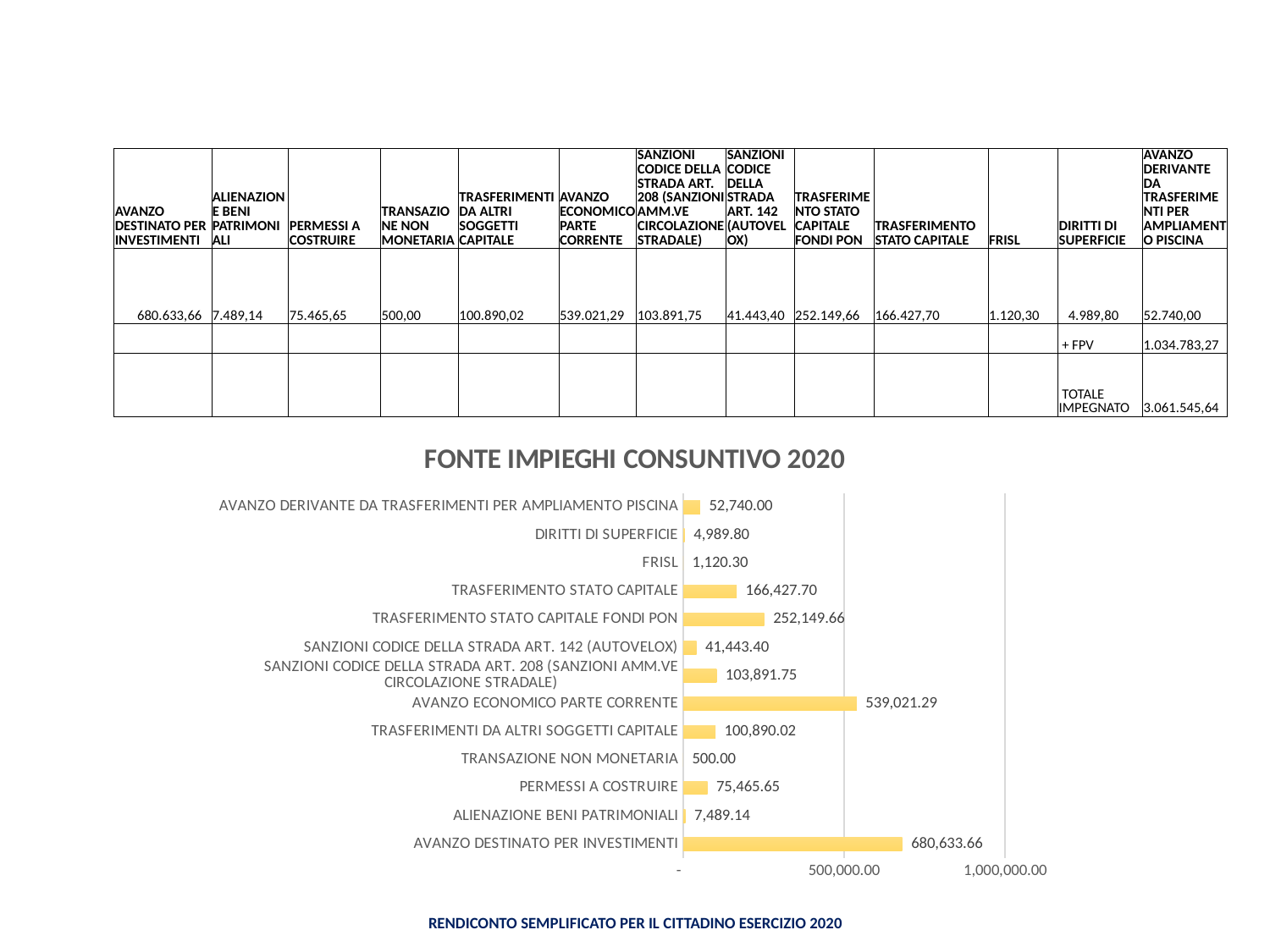
What is the value for FRISL? 1,120.30 What is the value for AVANZO DESTINATO PER INVESTIMENTI? 680,633.66 What is the value for SANZIONI CODICE DELLA STRADA ART. 142 (AUTOVELOX)? 41,443.40 Is the value for TRASFERIMENTO STATO CAPITALE FONDI PON greater or less than 500,000.00? less Which category has the lowest value? TRANSAZIONE NON MONETARIA What type of chart is shown on the slide? Bar chart Which category has the highest value? AVANZO DESTINATO PER INVESTIMENTI How many categories are shown in the chart? 13 What is the value for TRASFERIMENTO STATO CAPITALE FONDI PON? 252,149.66 What is the difference between TRASFERIMENTO STATO CAPITALE FONDI PON and TRASFERIMENTO STATO CAPITALE? 85,721.96 What is the difference between AVANZO DESTINATO PER INVESTIMENTI and AVANZO ECONOMICO PARTE CORRENTE? 141,612.37 Which is larger, PERMESSI A COSTRUIRE or ALIENAZIONE BENI PATRIMONIALI? PERMESSI A COSTRUIRE